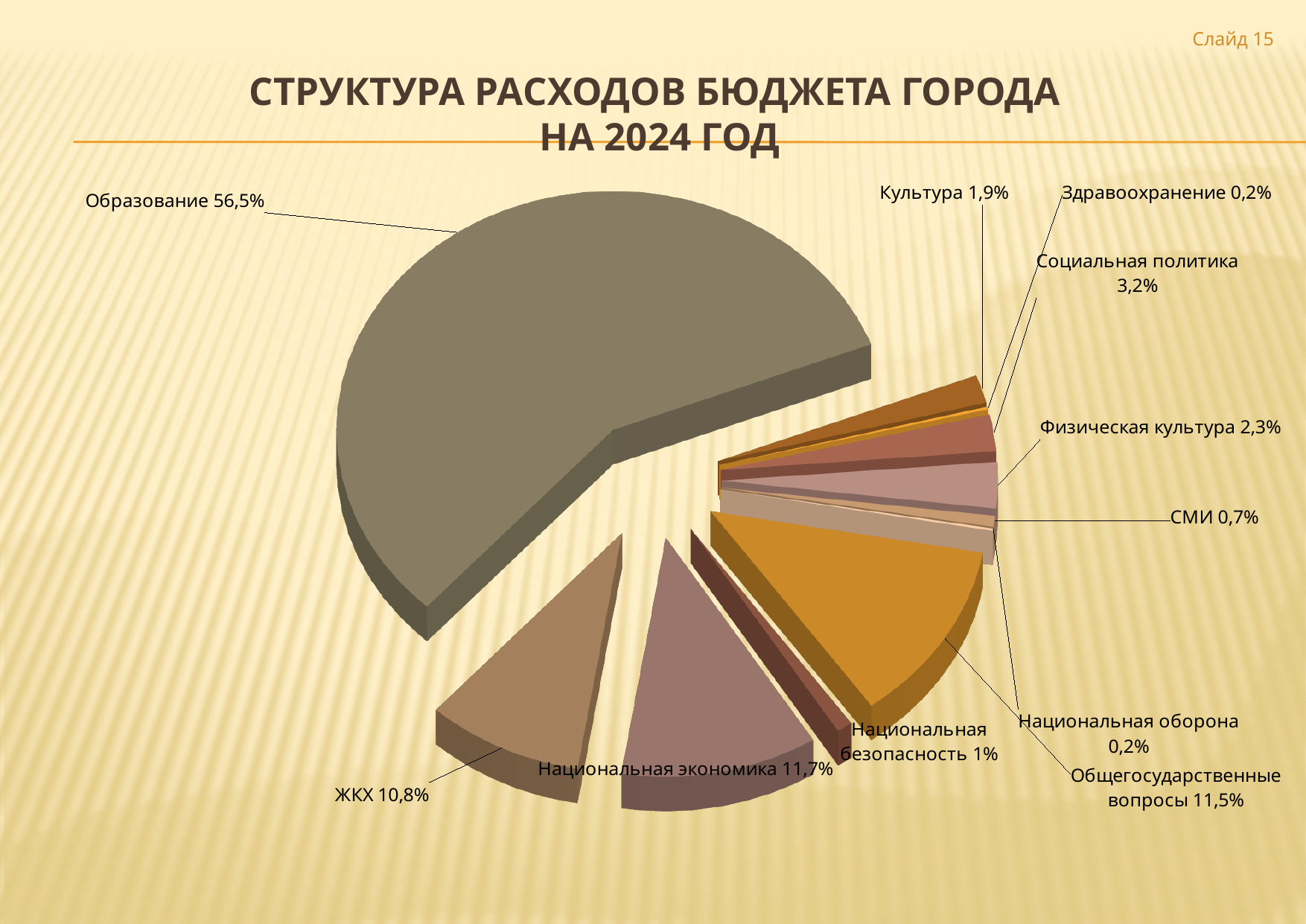
Which category has the largest share of the budget expenditure? Образование What is the difference in percentage points between Национальная экономика (11,7%) and Общегосударственные вопросы (11,5%)? 0,2 What percentage is labelled for ЖКХ? 10,8% What share of the city budget expenditure for 2024 goes to Образование? 56,5% What share is shown for Социальная политика? 3,2% What is the value for СМИ? 0,7% Which is larger, the share for Национальная экономика or for ЖКХ? Национальная экономика What is the value shown for Национальная экономика? 11,7% What type of chart is shown on the slide? Pie chart How many categories are shown in the pie chart? 11 What is the title of the chart on the slide? Структура расходов бюджета города на 2024 год By how many percentage points does Образование exceed ЖКХ? 45,7